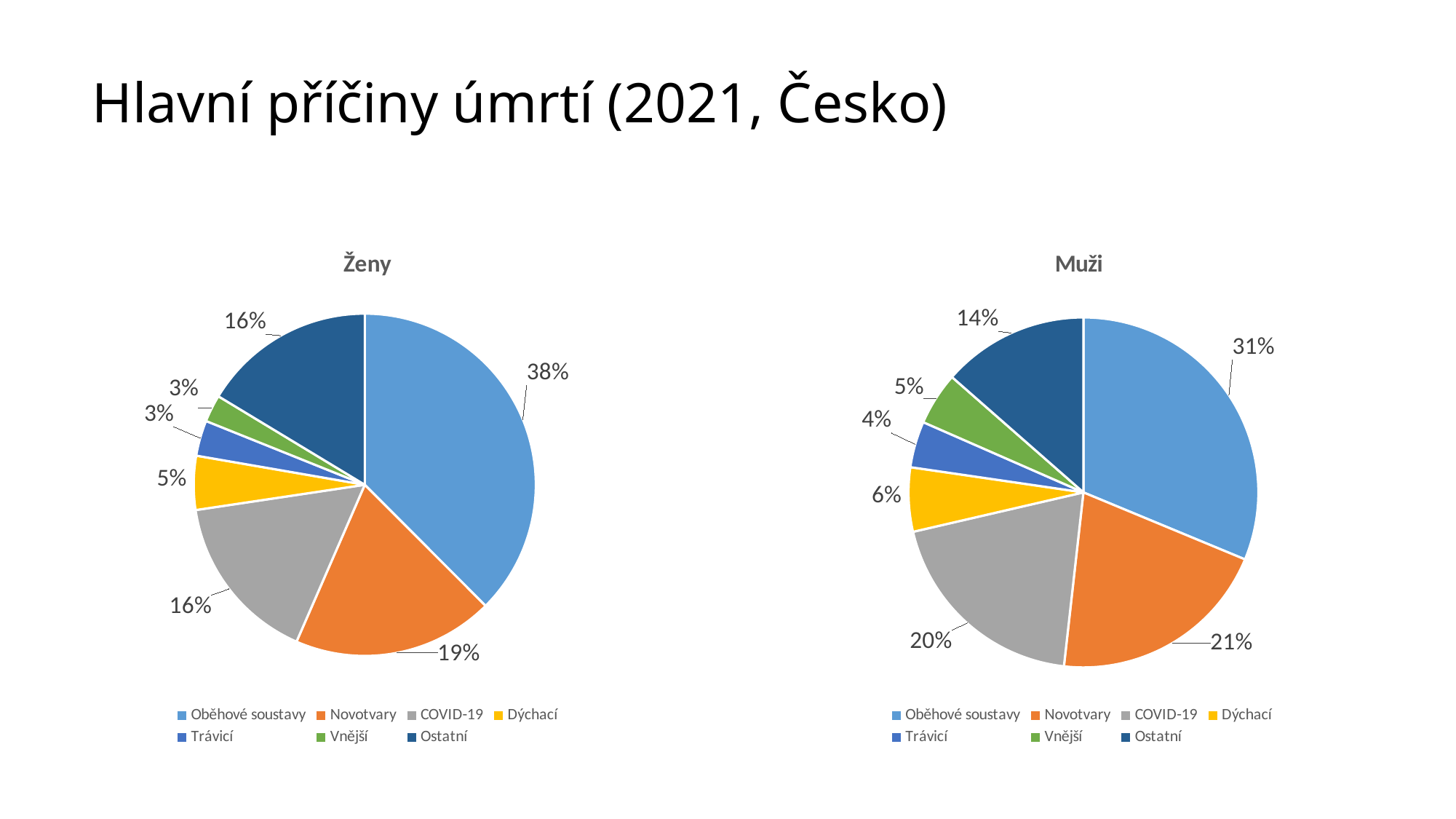
What type of chart is the "Muži" chart? Pie chart In the "Muži" chart, what share is labelled for COVID-19? 20% In the "Muži" chart, which category has the largest slice? Oběhové soustavy In the "Muži" chart, what is the difference between the Ostatní share and the Vnější share? 9% Which is larger: the COVID-19 share in the "Ženy" chart or the COVID-19 share in the "Muži" chart? Muži In the "Ženy" chart, what share is labelled for Oběhové soustavy? 38% In the "Ženy" chart, what is the difference between the Oběhové soustavy share and the Novotvary share? 19% What is the title of the slide? Hlavní příčiny úmrtí (2021, Česko) In the "Muži" chart, which category has the smallest slice? Trávicí In the "Muži" chart, what share is labelled for Novotvary? 21% In the "Ženy" chart, what share is labelled for Dýchací? 5% How many categories does the legend of the "Ženy" chart list? 7